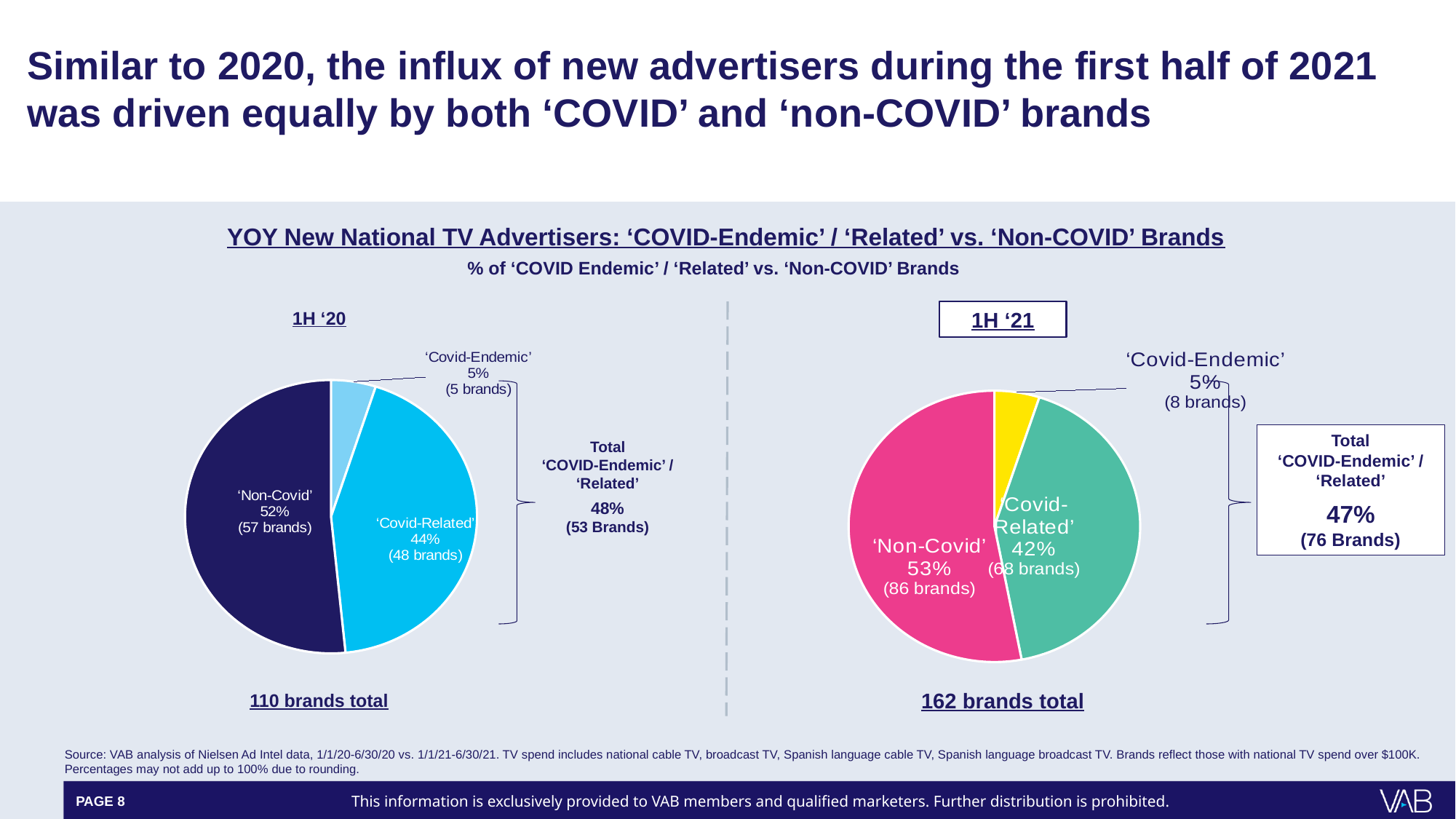
In the 1H '20 pie chart, which category has the largest share? 'Non-Covid' In the 1H '21 pie chart, which category has the smallest share? 'Covid-Endemic' What is the combined 'COVID-Endemic' / 'Related' share in the 1H '21 pie chart? 47% (76 Brands) What is the total number of brands shown for 1H '21? 162 brands total How many slices does the 1H '21 pie chart have? 3 In the 1H '21 pie chart, what share of brands is 'Covid-Endemic'? 5% In the 1H '20 pie chart, how many more 'Non-Covid' brands are there than 'Covid-Related' brands? 9 brands What colour is the 'Non-Covid' slice in the 1H '21 pie chart? Pink In the 1H '20 pie chart, what share of brands is 'Non-Covid'? 52% In the 1H '21 pie chart, is the 'Non-Covid' share larger or smaller than the 'Covid-Related' share? larger What type of chart is used to show the 1H '20 data? Pie chart In the 1H '21 pie chart, how many brands are 'Covid-Related'? 68 brands